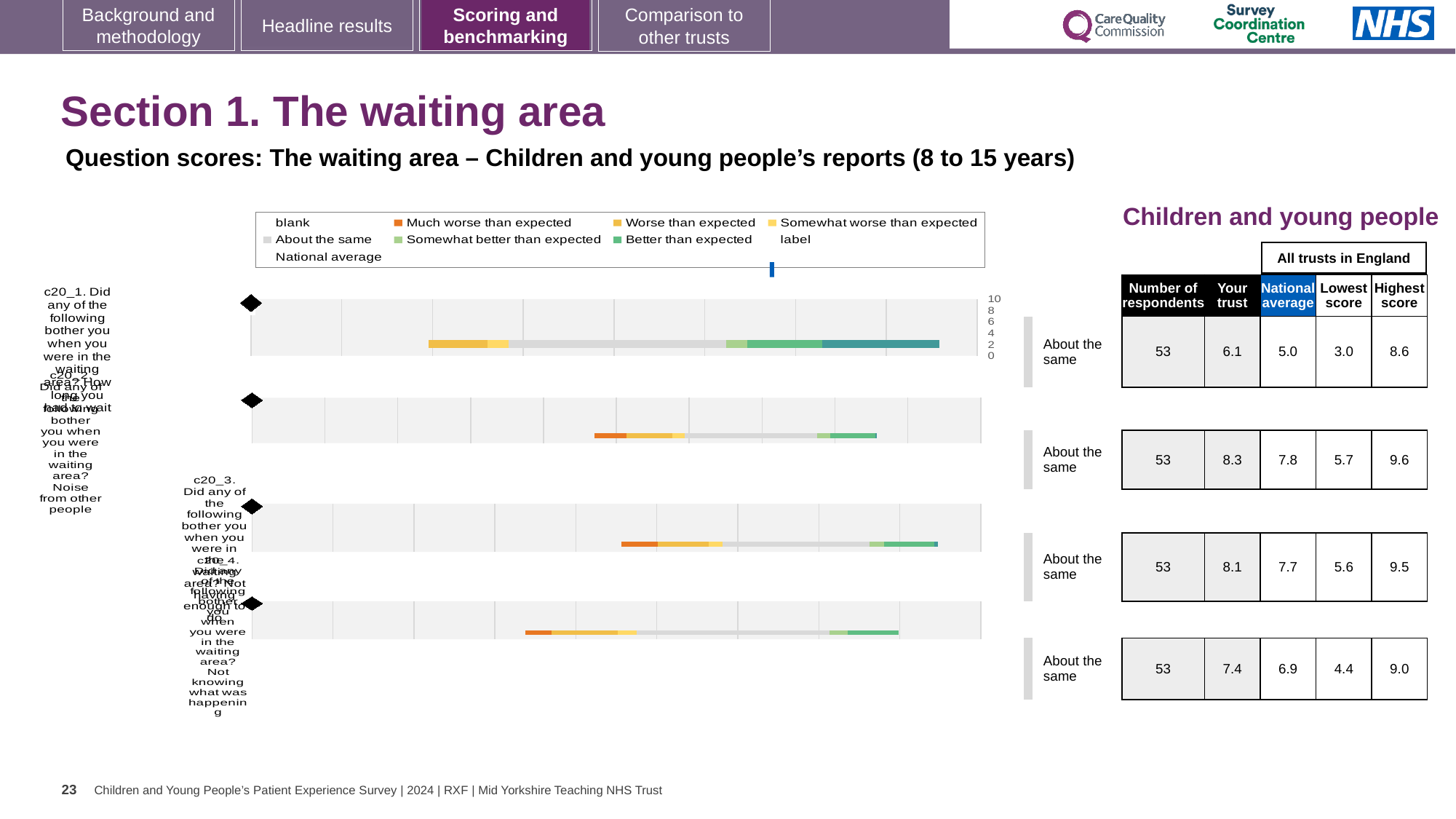
How many respondents are listed for each question row? 53 By how much does the 'Your trust' score for c20_1 exceed the national average for that question? 1.1 What is the highest score across all trusts in England for question c20_2? 9.6 What is the 'Your trust' score for question c20_2 (the second row)? 8.3 What is the difference between the highest and lowest scores across all trusts for question c20_4? 4.6 For question c20_3, which is larger: the 'Your trust' score or the national average? Your trust What kind of chart is used to show the question scores for the waiting area? bar chart What is the national average score for question c20_4 (the fourth row)? 6.9 What benchmark category is shown next to each of the four bars? About the same How many question rows (bars) are plotted in the chart? 4 Which question row has the highest 'Your trust' score? c20_2 Which question row has the lowest 'Your trust' score? c20_1